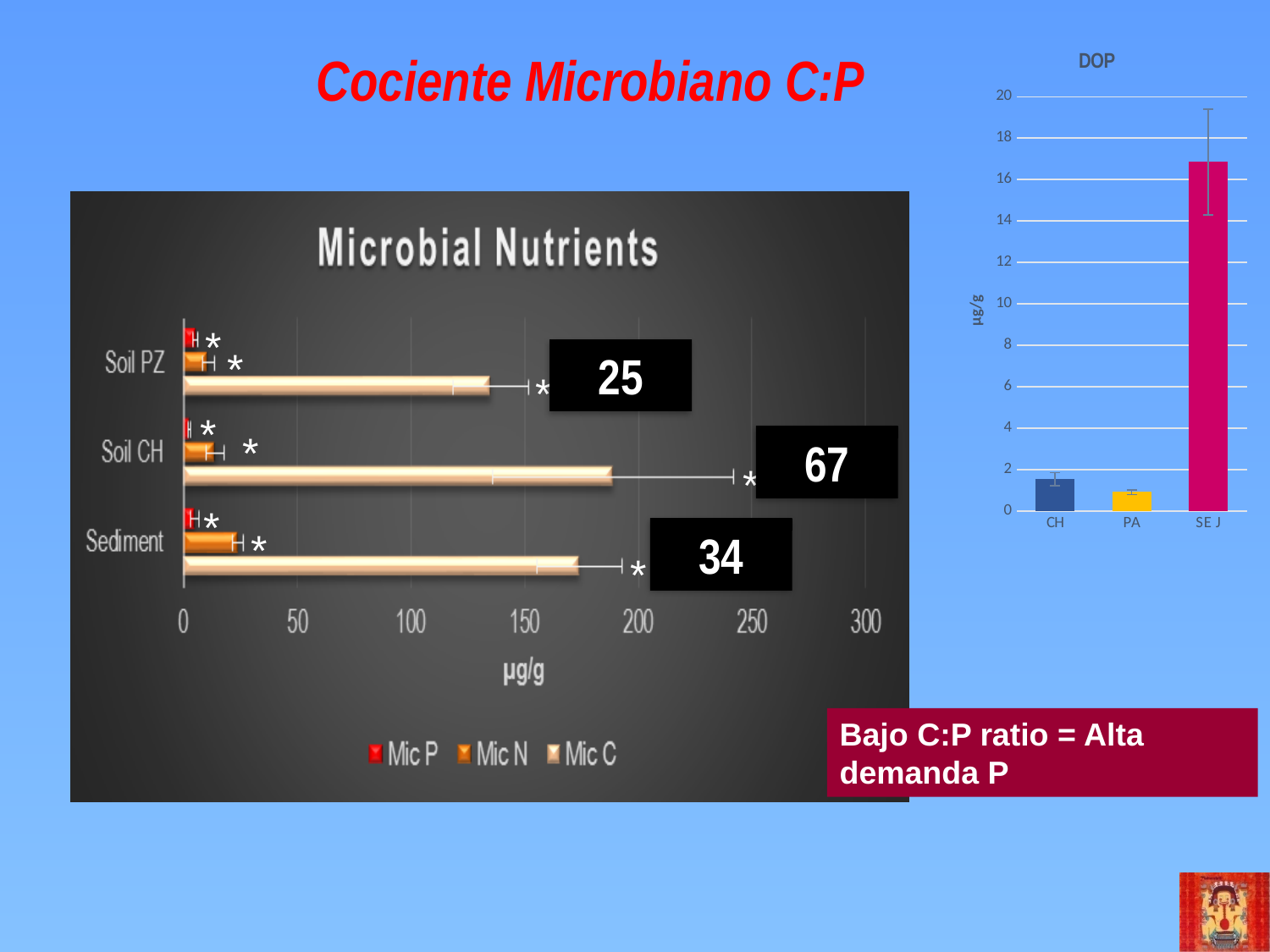
In the "Microbial Nutrients" chart, which category has the shortest Mic C bar? Soil PZ How many categories are shown on the "Microbial Nutrients" chart? 3 What kind of chart is the "Microbial Nutrients" chart? bar chart How many series does the legend of the "Microbial Nutrients" chart list? 3 In the "Microbial Nutrients" chart, which category has the longest Mic C bar? Soil CH In the "DOP" chart, which category has the highest value? SE J How many categories are shown on the "DOP" chart? 3 In the "DOP" chart, is the value for PA greater or less than 2? less In the "Microbial Nutrients" chart, is the Mic C value for Soil PZ greater or less than 150? less In the "Microbial Nutrients" chart, what unit is shown on the x axis? µg/g In the "Microbial Nutrients" chart, is the Mic C value for Soil CH greater or less than 150? greater